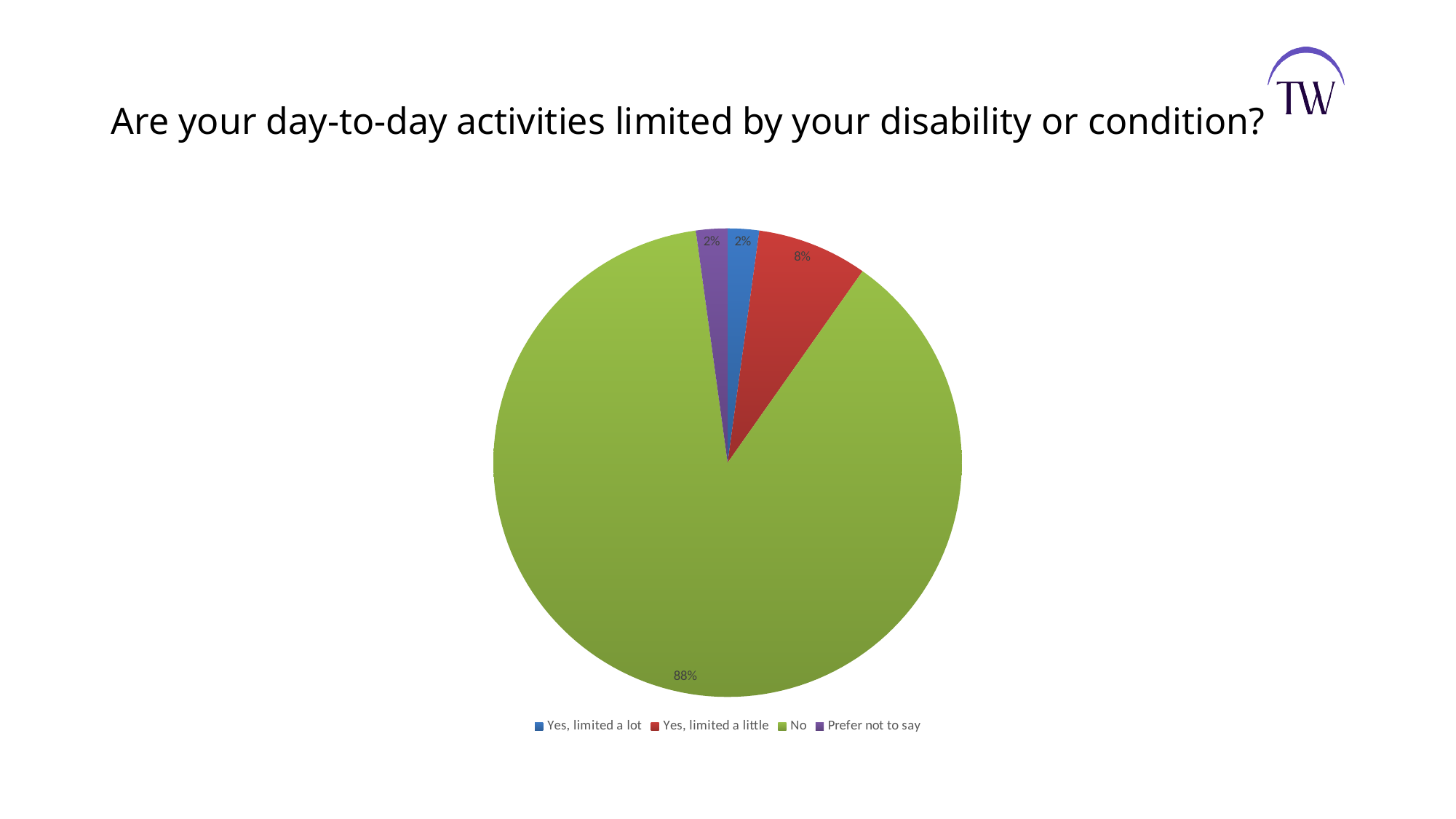
What is the difference in percentage points between the "No" slice and the "Yes, limited a little" slice? 80 What share of the pie is labelled "Prefer not to say"? 2% What is the title of the chart on the slide? Are your day-to-day activities limited by your disability or condition? What share of the pie is labelled "Yes, limited a little"? 8% How many entries does the legend list? 4 Which is larger, the "Yes, limited a little" slice or the "Yes, limited a lot" slice? Yes, limited a little How many slices does the pie chart have? 4 What share of the pie is labelled "No"? 88% What colour is the "No" slice of the pie? green What kind of chart is shown on the slide? pie chart Which category has the largest slice of the pie? No